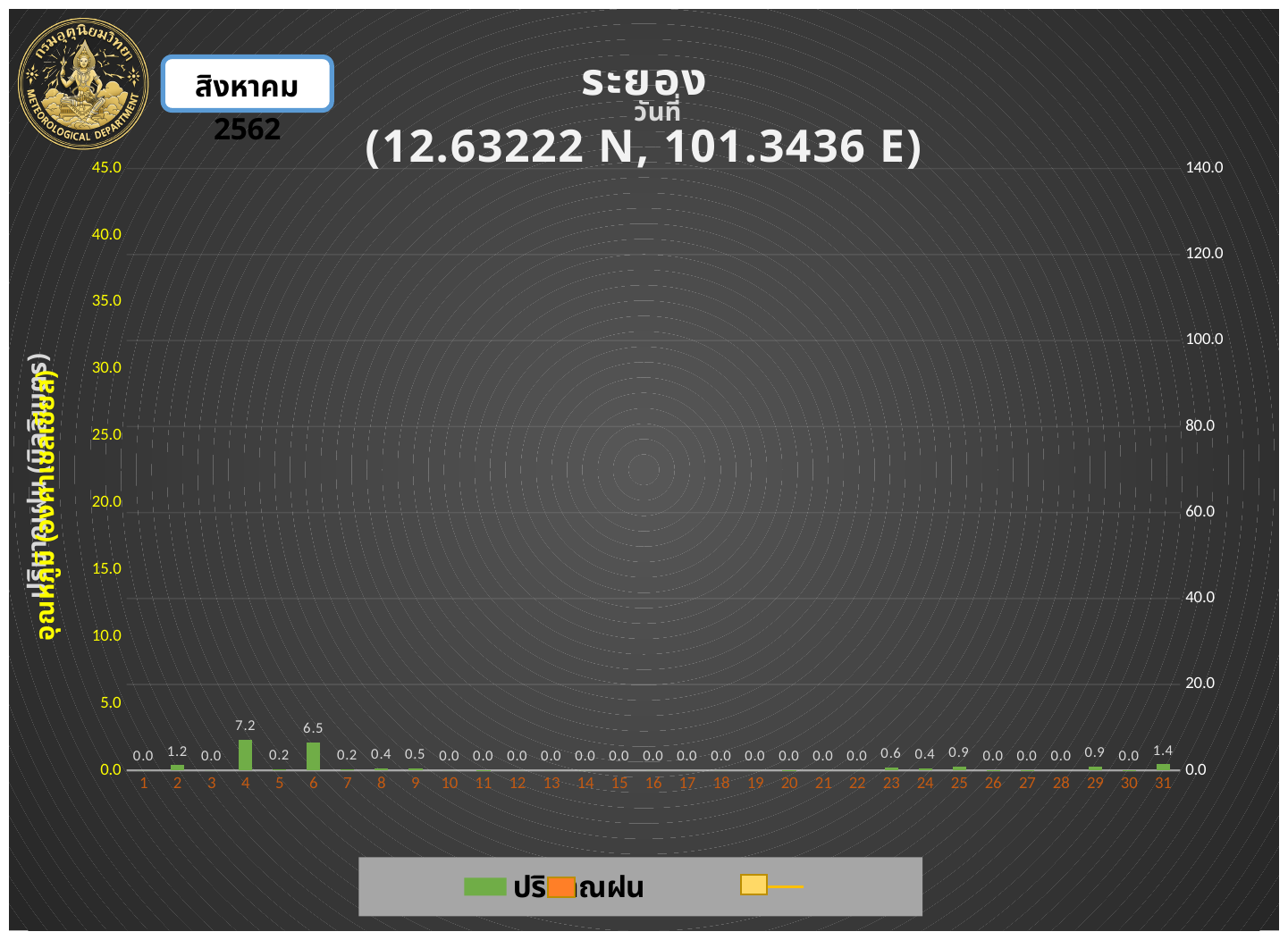
What kind of chart is this? bar chart How many days are shown on the x axis? 31 What is the value for day 31? 1.4 Which day has the highest value? 4 What is the value for day 4? 7.2 What is the difference between the values for day 25 and day 23? 0.3 Which is larger, the value for day 2 or the value for day 31? day 31 What is the value for day 6? 6.5 What is the value for day 2? 1.2 What is the value for day 25? 0.9 What is the difference between the values for day 4 and day 6? 0.7